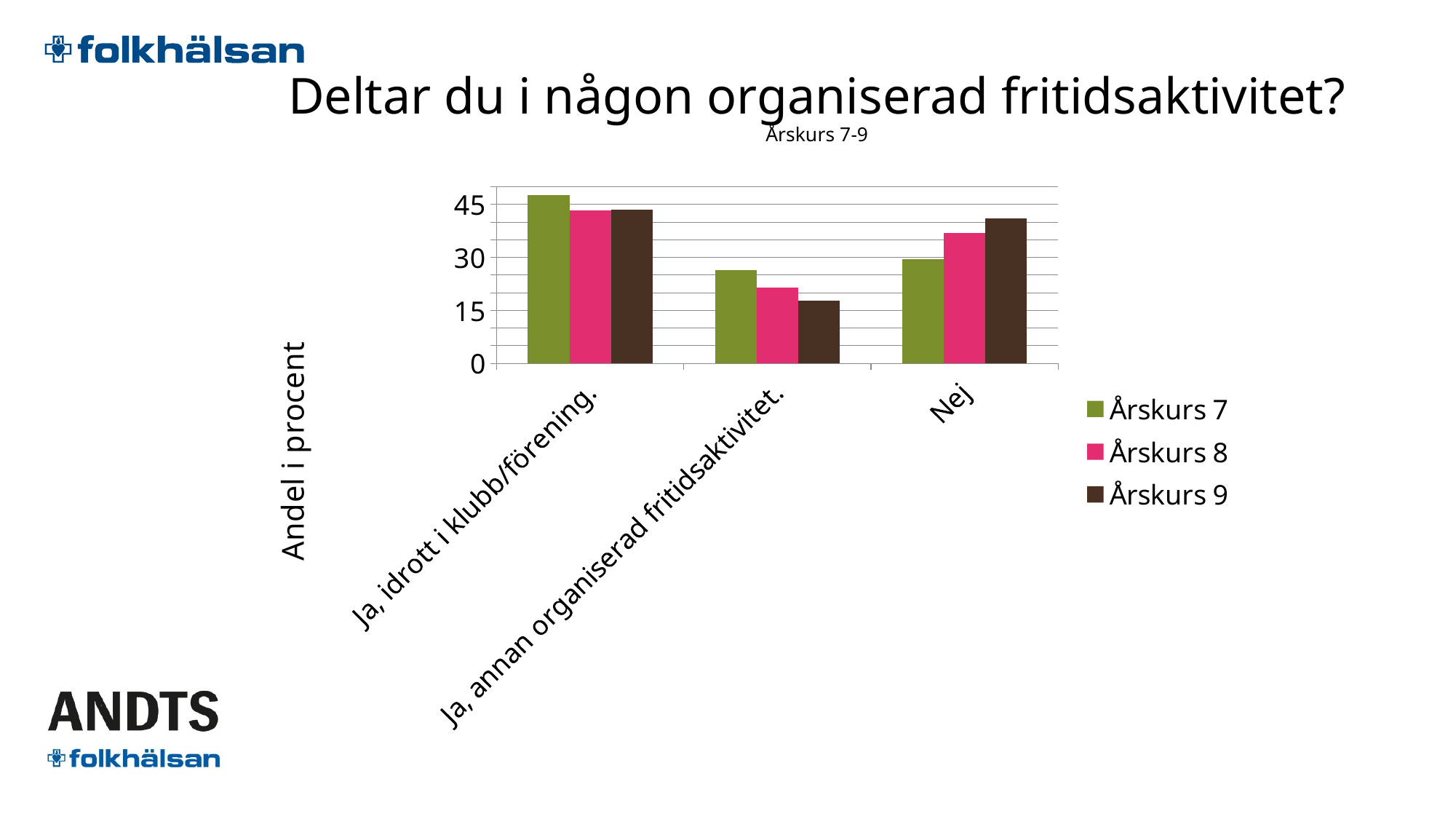
How many categories are shown on the x axis? 3 What is the title of the vertical axis? Andel i procent For the category Ja, idrott i klubb/förening., which is larger: Årskurs 7 or Årskurs 8? Årskurs 7 Which category has the lowest value for Årskurs 9? Ja, annan organiserad fritidsaktivitet. Which series has the highest value for the category Nej? Årskurs 9 Which series has the lowest value for the category Ja, annan organiserad fritidsaktivitet.? Årskurs 9 Is the value for Årskurs 9 in the category Nej greater or less than 30? greater Is the value for Årskurs 9 in the category Ja, annan organiserad fritidsaktivitet. greater or less than 30? less How many series does the legend list? 3 Which category has the highest value for Årskurs 7? Ja, idrott i klubb/förening. What kind of chart is shown on the slide? bar chart For the category Nej, which is larger: Årskurs 7 or Årskurs 9? Årskurs 9